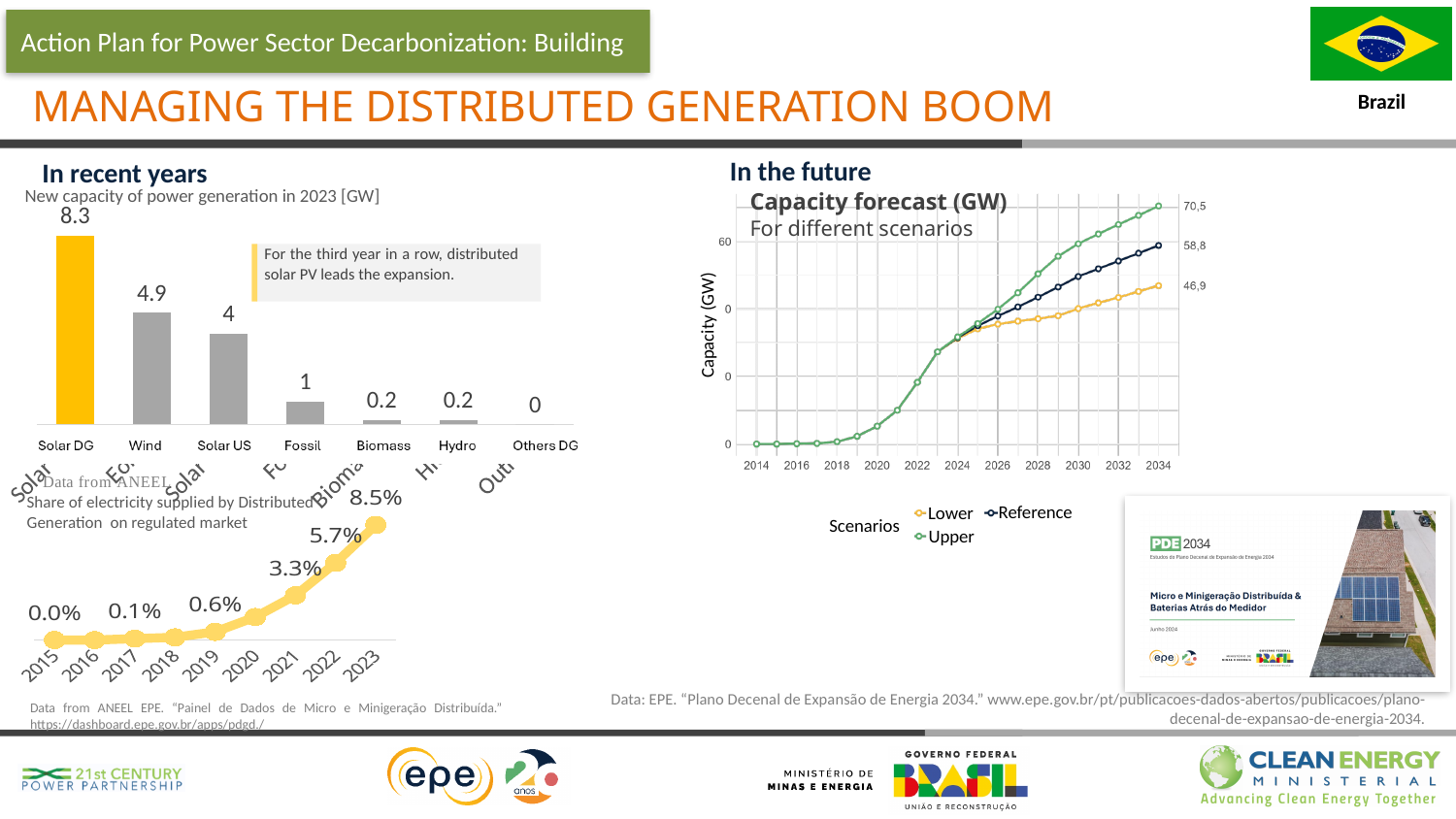
In the 'New capacity of power generation in 2023 [GW]' bar chart, which is larger, Solar US or Fossil? Solar US What kind of chart is the 'New capacity of power generation in 2023 [GW]' chart? Bar chart How many categories are shown in the 'New capacity of power generation in 2023 [GW]' bar chart? 7 In the 'New capacity of power generation in 2023 [GW]' bar chart, what is the value for Wind? 4.9 In the 'New capacity of power generation in 2023 [GW]' bar chart, what is the value for Solar DG? 8.3 In the 'Share of electricity supplied by Distributed Generation on regulated market' chart, do the values rise or fall from 2015 to 2023? Rise How many scenarios does the legend of the 'Capacity forecast (GW)' chart list? 3 In the 'New capacity of power generation in 2023 [GW]' bar chart, which category has the lowest value? Others DG In the 'New capacity of power generation in 2023 [GW]' bar chart, what is the difference between Solar DG and Wind? 3.4 In the 'New capacity of power generation in 2023 [GW]' bar chart, which category has the highest value? Solar DG In the 'Capacity forecast (GW)' chart, what is the 2034 value for the Upper scenario? 70,5 In the 'Share of electricity supplied by Distributed Generation on regulated market' chart, what is the value for 2023? 8.5%